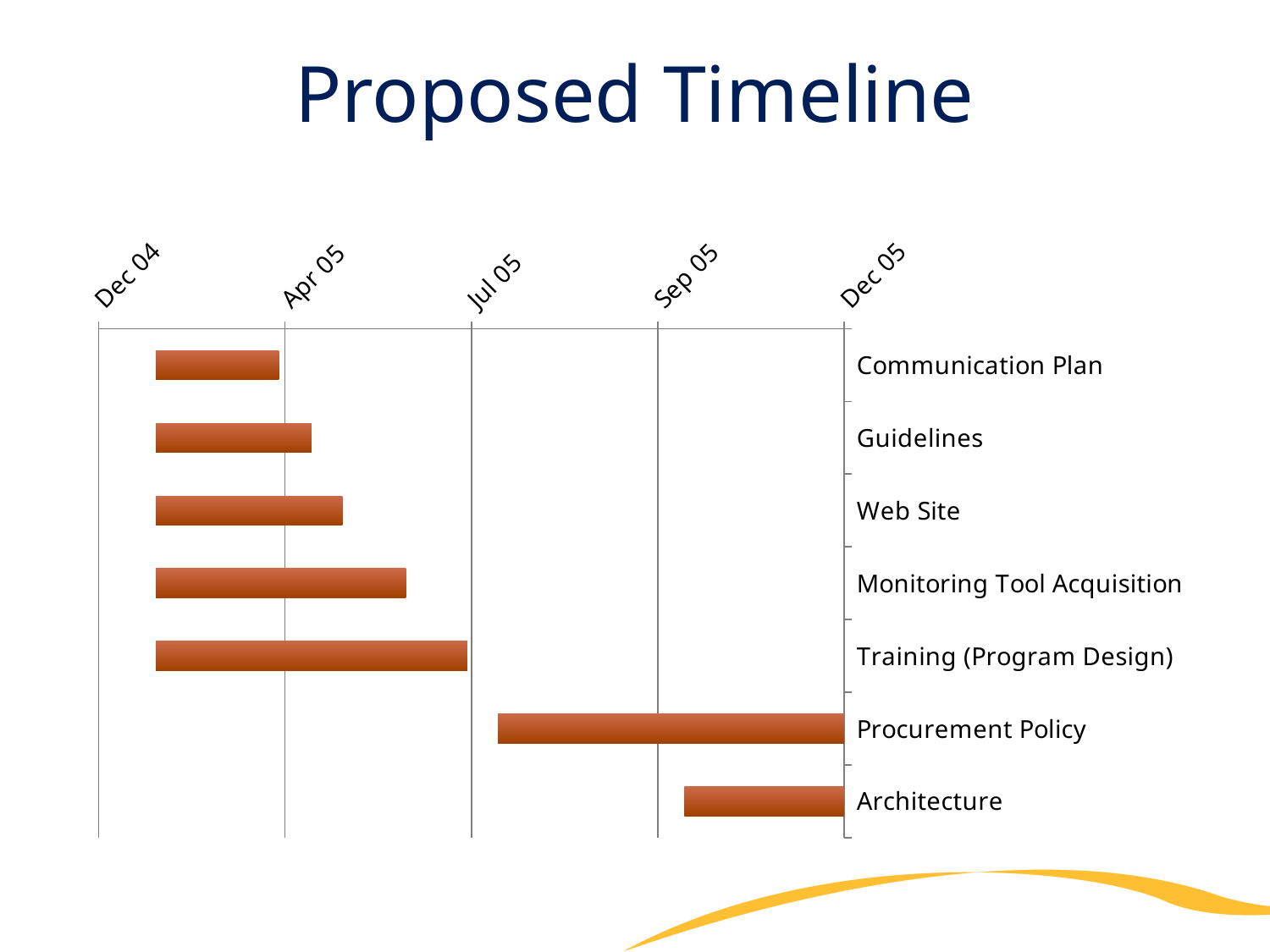
How many tasks are listed on the chart? 7 What is the title of the slide? Proposed Timeline Which task starts later, Procurement Policy or Architecture? Architecture Which bar is longer, Web Site or Guidelines? Web Site Which task is listed last (at the bottom) on the chart? Architecture Does the Architecture bar start before or after Sep 05? after Does the Procurement Policy bar start before or after Jul 05? after Does the Monitoring Tool Acquisition bar end before or after Jul 05? before What type of chart is shown on the slide? bar chart Which task has the shortest bar? Communication Plan How many date labels are shown along the time axis? 5